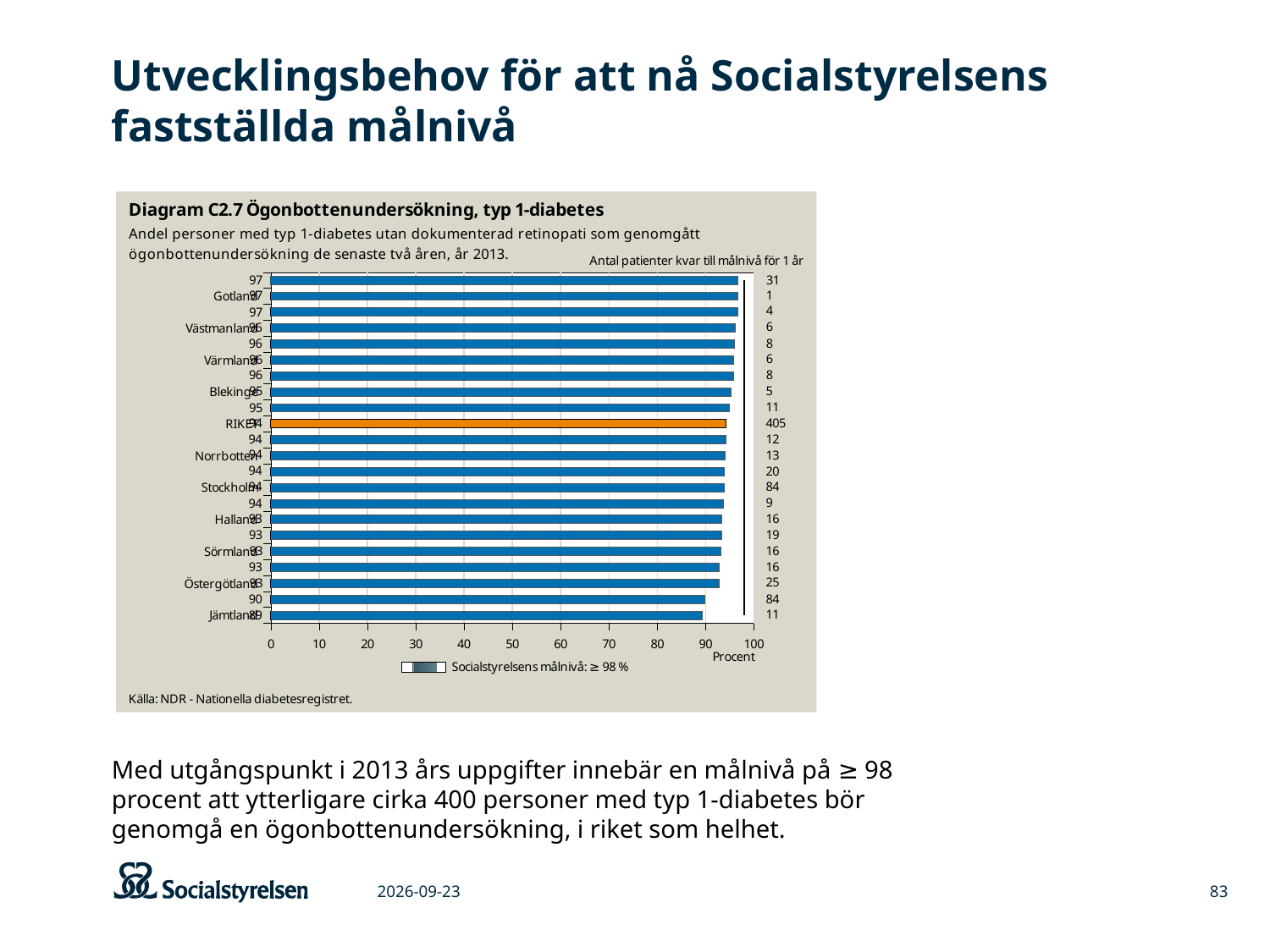
Which has a higher percentage, Blekinge or Halland? Blekinge What target level (målnivå) does the legend state for Socialstyrelsen? ≥ 98 % Which labelled region has the lowest percentage in the chart? Jämtland How many patients remain to reach the target level for one year (Antal patienter kvar till målnivå för 1 år) for RIKET? 405 How many patients remain to reach the target level for one year for Stockholm? 84 How many bars are plotted in the chart? 22 What is the percentage value shown for Blekinge? 95 What is the difference in percentage points between Gotland and Jämtland? 8 What is the percentage value shown for RIKET? 94 What is the percentage value shown for Gotland? 97 What type of chart is shown in Diagram C2.7? bar chart What is the percentage value shown for Jämtland? 89